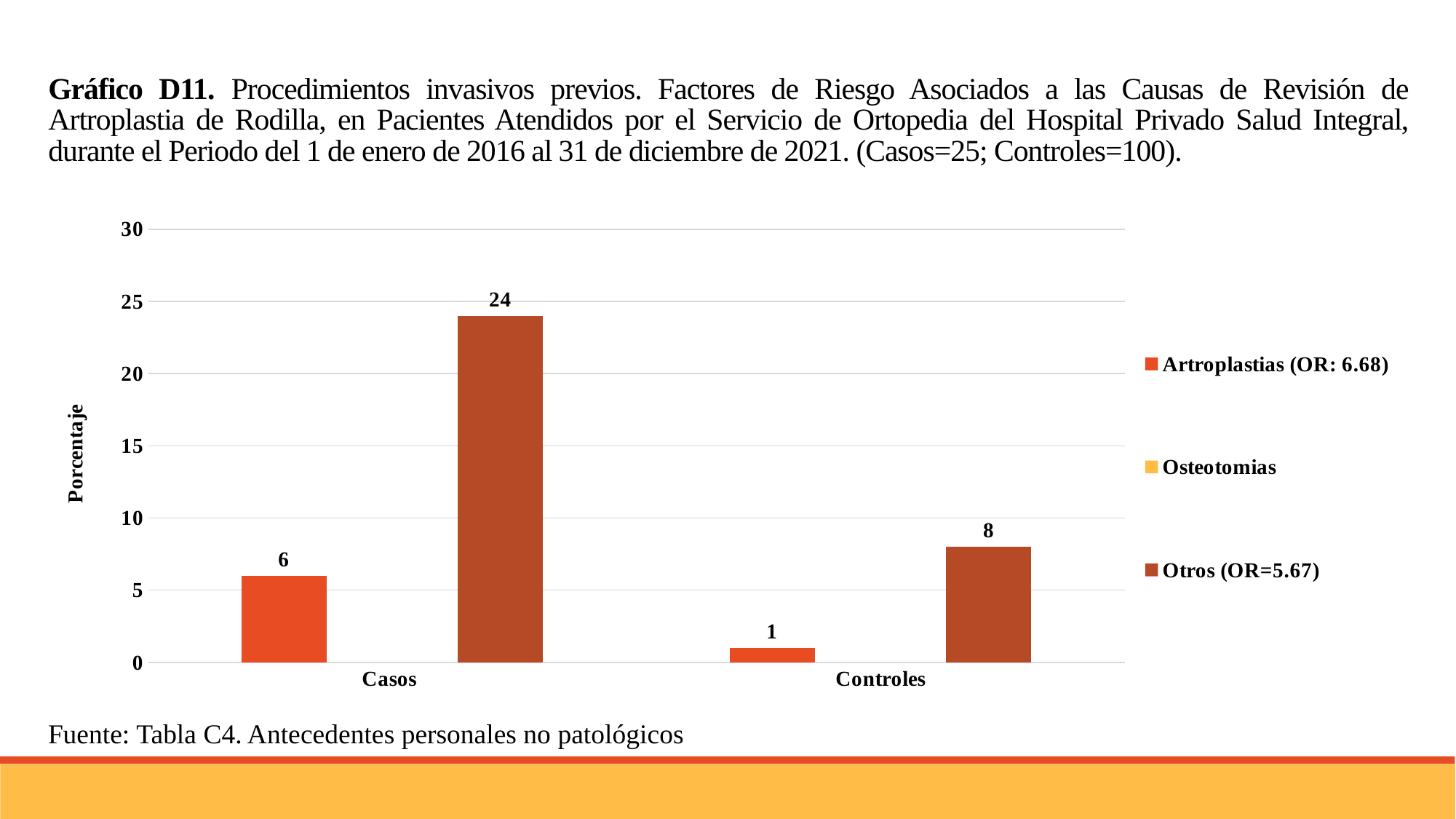
What is the difference between the Otros (OR=5.67) values for Casos and Controles? 16 What is the value for Artroplastias (OR: 6.68) in the Casos category? 6 What is the value for Otros (OR=5.67) in the Casos category? 24 What is the value for Otros (OR=5.67) in the Controles category? 8 What kind of chart is shown on the slide? Bar chart What is the label of the y axis? Porcentaje How many series does the legend list? 3 How many categories are shown on the x axis? 2 Which bar has the highest value on the chart? Otros (OR=5.67) in Casos Which is larger: the Artroplastias (OR: 6.68) value for Casos or for Controles? Casos Which bar has the lowest value on the chart? Artroplastias (OR: 6.68) in Controles What is the value for Artroplastias (OR: 6.68) in the Controles category? 1